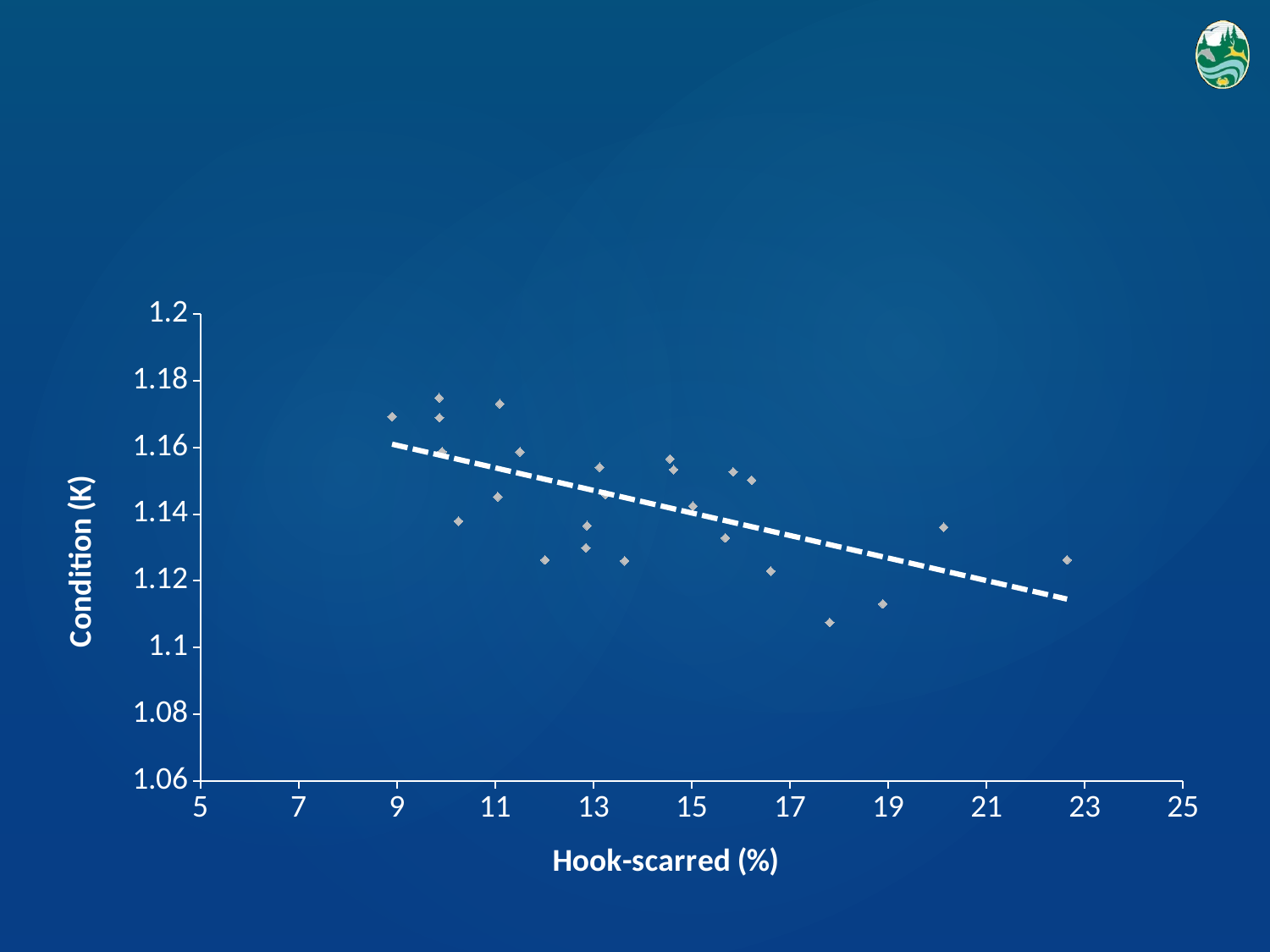
As the hook-scarred percentage increases along the x axis, does the condition (K) generally rise or fall? fall What is the label of the x axis? Hook-scarred (%) What kind of chart is shown on the slide? scatter chart Is the hook-scarred percentage of the rightmost point greater or less than 21? greater Is the condition (K) value of the point with the highest hook-scarred percentage greater or less than 1.14? less At a hook-scarred value of 23%, is the dashed trend line above or below a condition of 1.12? below Does the dashed trend line slope upward or downward from left to right? downward What is the label of the y axis? Condition (K)